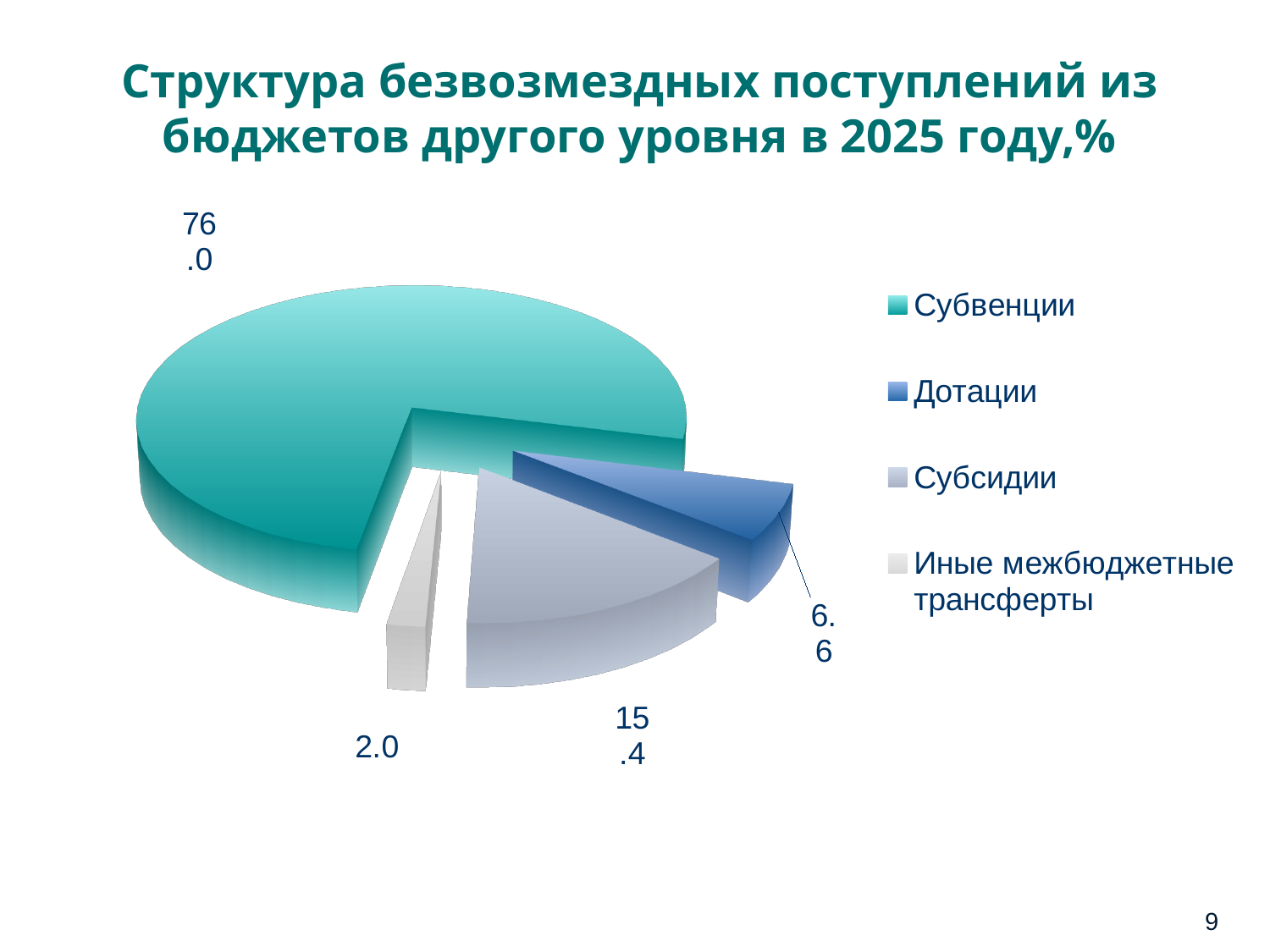
What is the value for Иные межбюджетные трансферты? 2.0 What is the value for Субсидии? 15.4 Which category has the largest slice of the pie? Субвенции Which is larger, the value for Дотации or the value for Иные межбюджетные трансферты? Дотации What kind of chart is shown on the slide? pie chart What is the value for Дотации? 6.6 What is the title of the chart? Структура безвозмездных поступлений из бюджетов другого уровня в 2025 году,% Which category has the smallest slice of the pie? Иные межбюджетные трансферты What is the difference between the values for Субвенции and Субсидии? 60.6 What is the difference between the values for Субсидии and Дотации? 8.8 How many categories does the pie chart have? 4 What is the value for Субвенции? 76.0